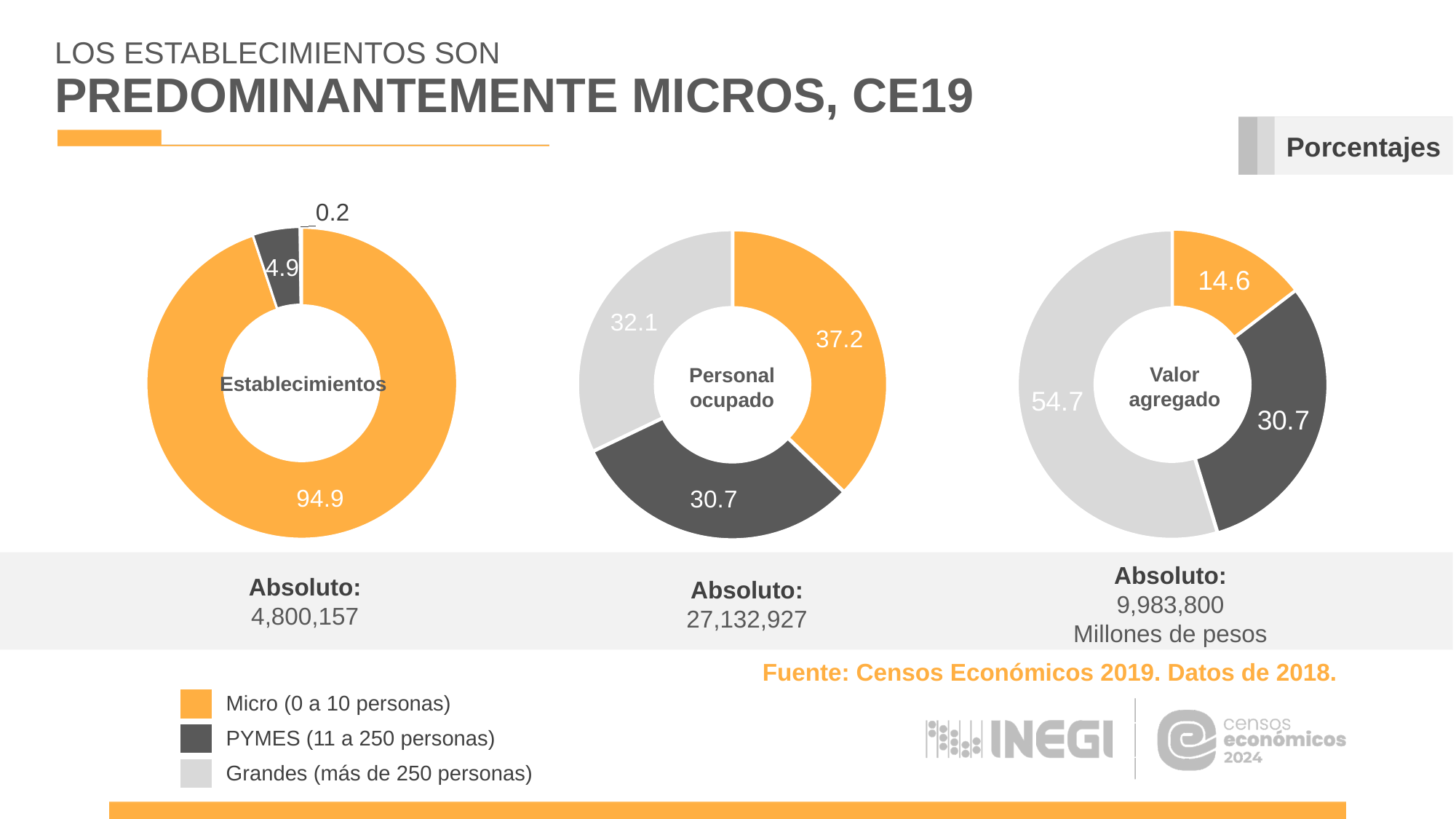
In the Personal ocupado chart, what is the difference between the Micro share and the PYMES share? 6.5 In the Personal ocupado chart, what percentage corresponds to Grandes (más de 250 personas)? 32.1 How many categories does the legend list? 3 In the Establecimientos chart, what percentage corresponds to Grandes (más de 250 personas)? 0.2 In the Personal ocupado chart, which is larger: the Grandes share or the PYMES share? Grandes (más de 250 personas) What kind of chart is used for Establecimientos, Personal ocupado and Valor agregado? Donut (pie) chart In the Valor agregado chart, what percentage corresponds to Grandes (más de 250 personas)? 54.7 In the Establecimientos chart, what percentage corresponds to PYMES (11 a 250 personas)? 4.9 In the Valor agregado chart, which category has the largest share? Grandes (más de 250 personas) In the Personal ocupado chart, what percentage corresponds to Micro (0 a 10 personas)? 37.2 In the Valor agregado chart, which category has the smallest share? Micro (0 a 10 personas) In the Establecimientos chart, what percentage corresponds to Micro (0 a 10 personas)? 94.9